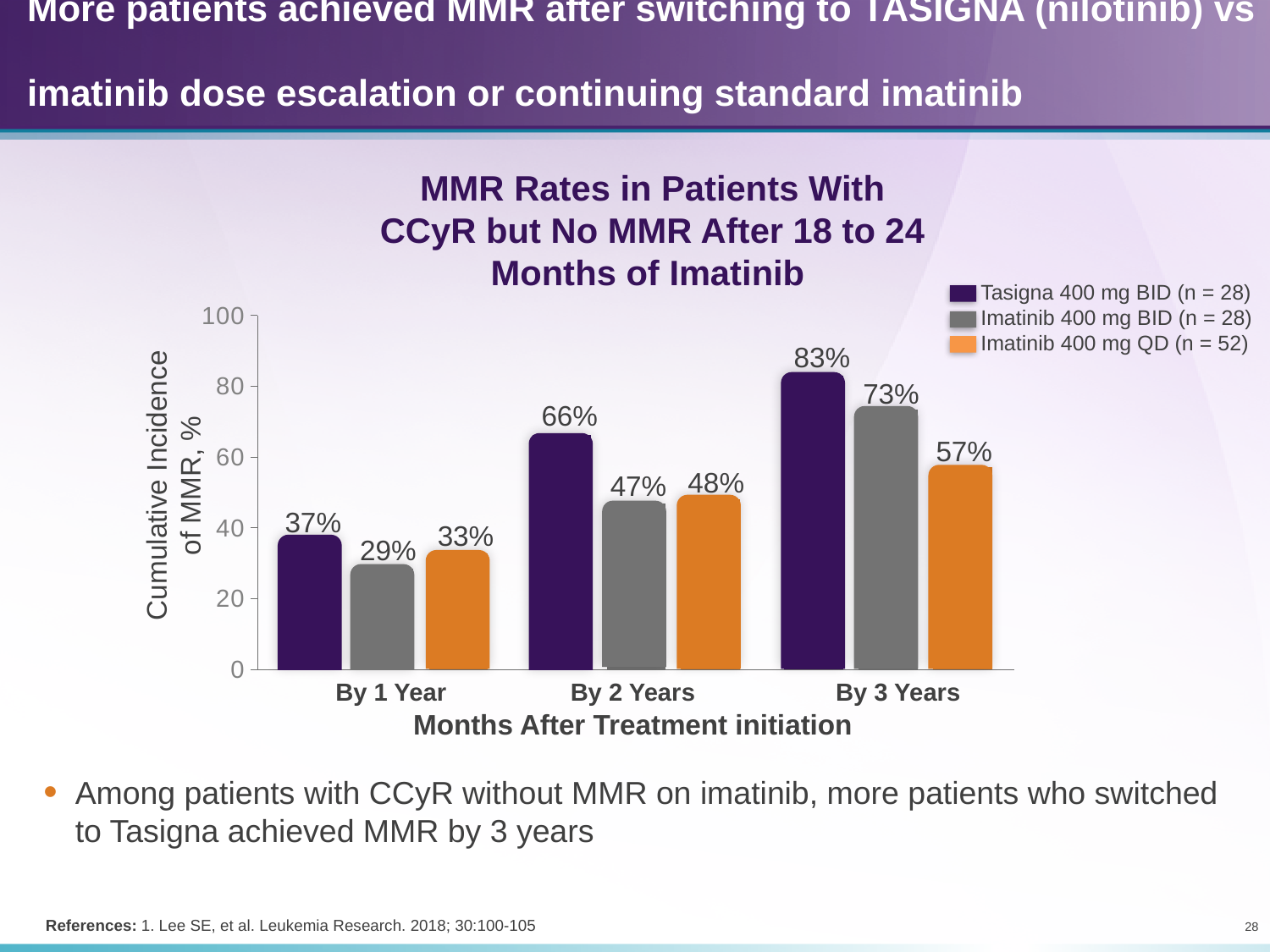
By 2 years, which is larger: the MMR rate for Tasigna 400 mg BID or for Imatinib 400 mg BID? Tasigna 400 mg BID Which treatment group has the lowest MMR rate by 1 year? Imatinib 400 mg BID (n = 28) How many series does the legend list? 3 What is the label of the y axis? Cumulative Incidence of MMR, % Which treatment group has the highest MMR rate by 3 years? Tasigna 400 mg BID (n = 28) What is the MMR rate for Tasigna 400 mg BID by 3 years? 83% Does the MMR rate for Imatinib 400 mg QD rise or fall from 1 year to 3 years? Rise How many time-point categories are shown on the x axis? 3 What kind of chart is shown on the slide? Bar chart What is the MMR rate for Imatinib 400 mg QD by 1 year? 33% What is the difference between the Tasigna 400 mg BID and Imatinib 400 mg QD MMR rates by 3 years? 26% What is the MMR rate for Imatinib 400 mg BID by 2 years? 47%